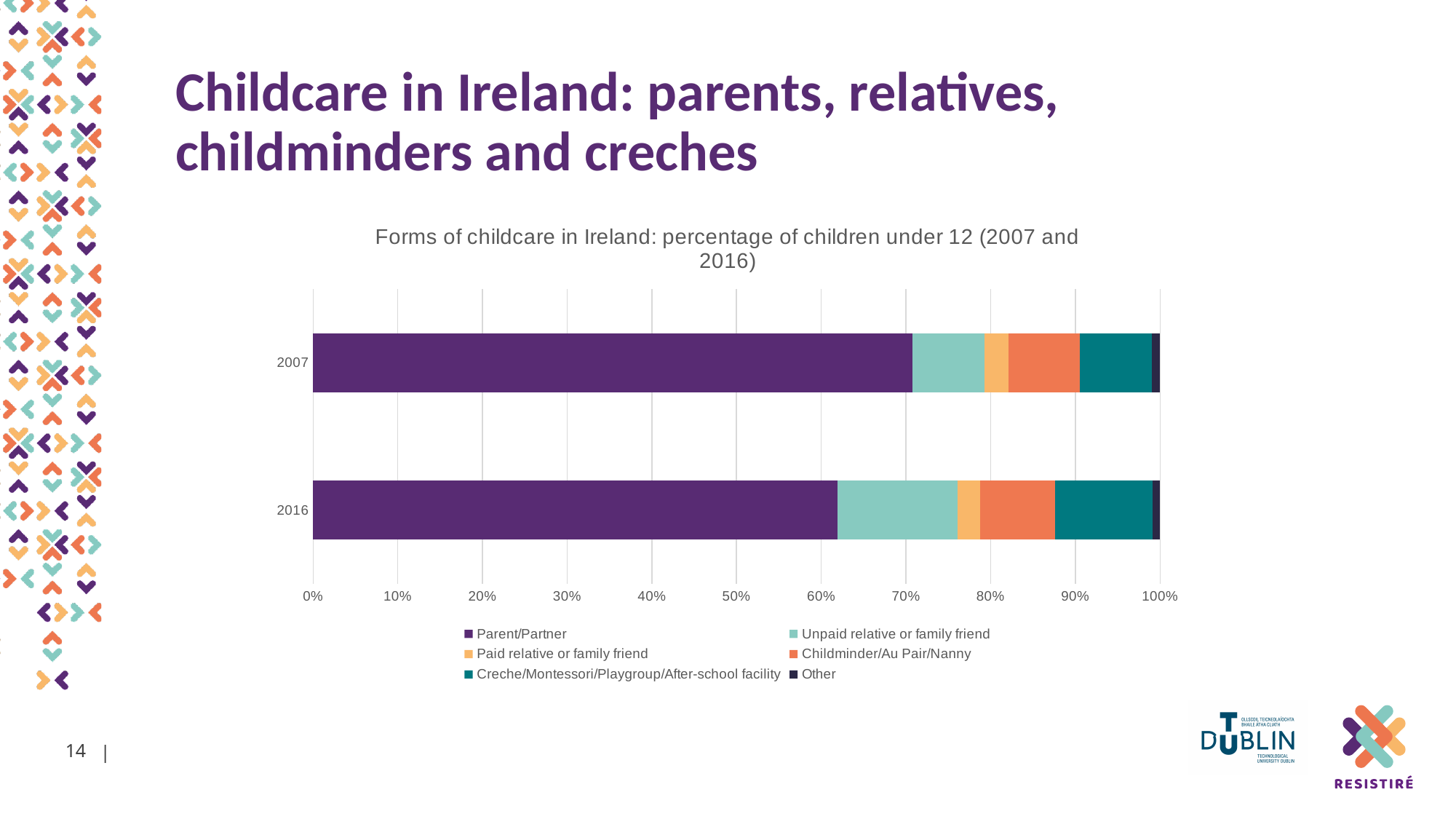
Which legend entry is shown in dark navy? Other Which form of childcare accounts for the largest share of the 2016 bar? Parent/Partner Is the Parent/Partner share in 2016 greater or less than 70%? less How many years (bars) are plotted in the chart? 2 What is the title of the chart? Forms of childcare in Ireland: percentage of children under 12 (2007 and 2016) What kind of chart is shown on the slide? Stacked bar chart Which form of childcare accounts for the largest share of the 2007 bar? Parent/Partner In which year is the Unpaid relative or family friend share larger, 2007 or 2016? 2016 Is the Parent/Partner share in 2007 greater or less than 60%? greater Does the Parent/Partner share rise or fall from 2007 to 2016? fall How many series does the legend list? 6 Is the Parent/Partner share in 2007 larger or smaller than in 2016? larger